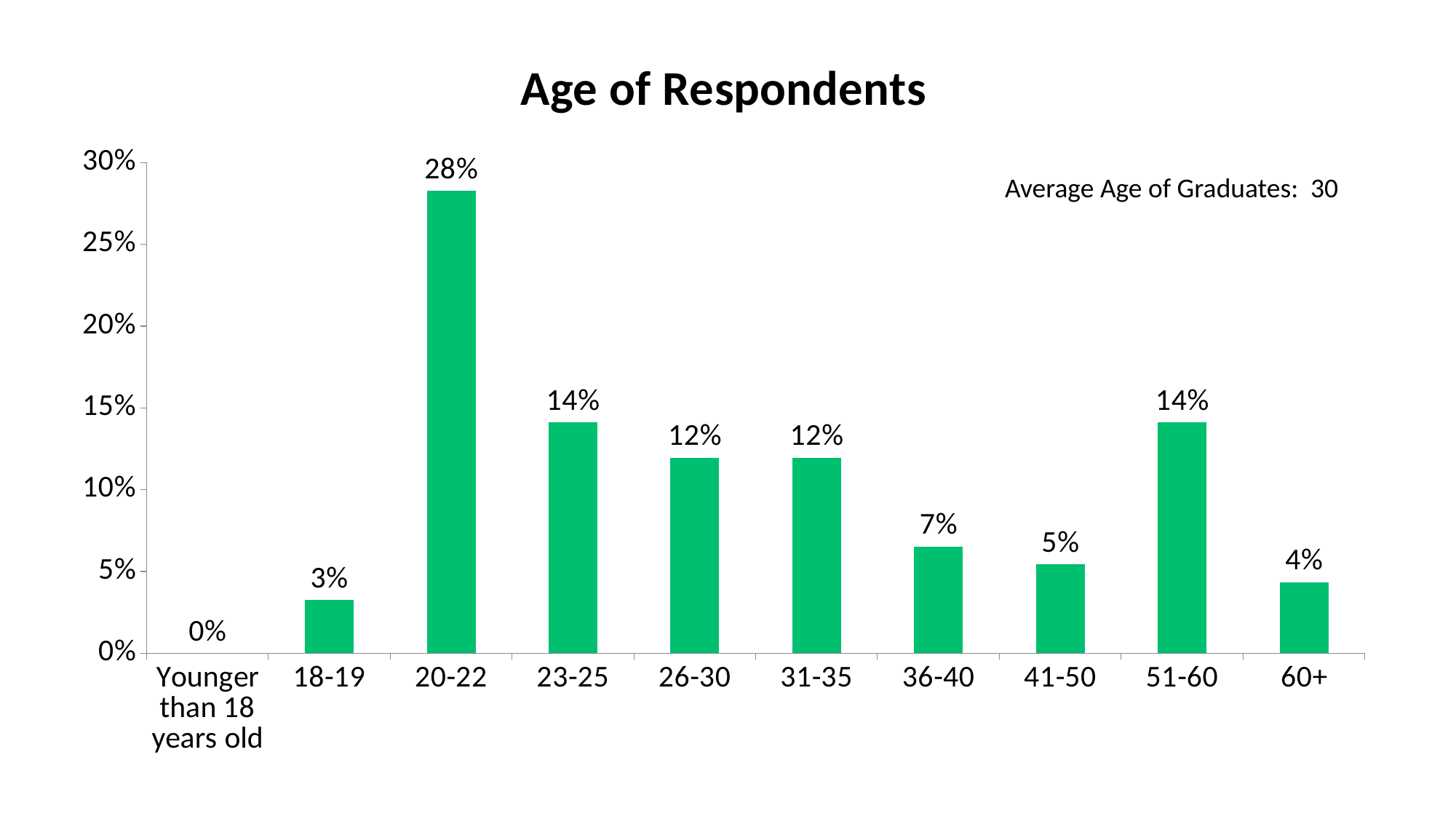
What percentage of respondents are aged 60+? 4% How many age groups are shown on the x axis? 10 What kind of chart is shown on the slide? Bar chart Which age group has the highest percentage of respondents? 20-22 Which age group has a larger share of respondents, 41-50 or 51-60? 51-60 What is the title of the chart? Age of Respondents What is the difference in percentage points between the 20-22 and 23-25 age groups? 14% Is the value for the 26-30 age group greater or less than 10%? greater What percentage of respondents are aged 36-40? 7% Which age group has the lowest percentage of respondents? Younger than 18 years old What is the average age of graduates stated on the slide? 30 What percentage of respondents are aged 20-22? 28%